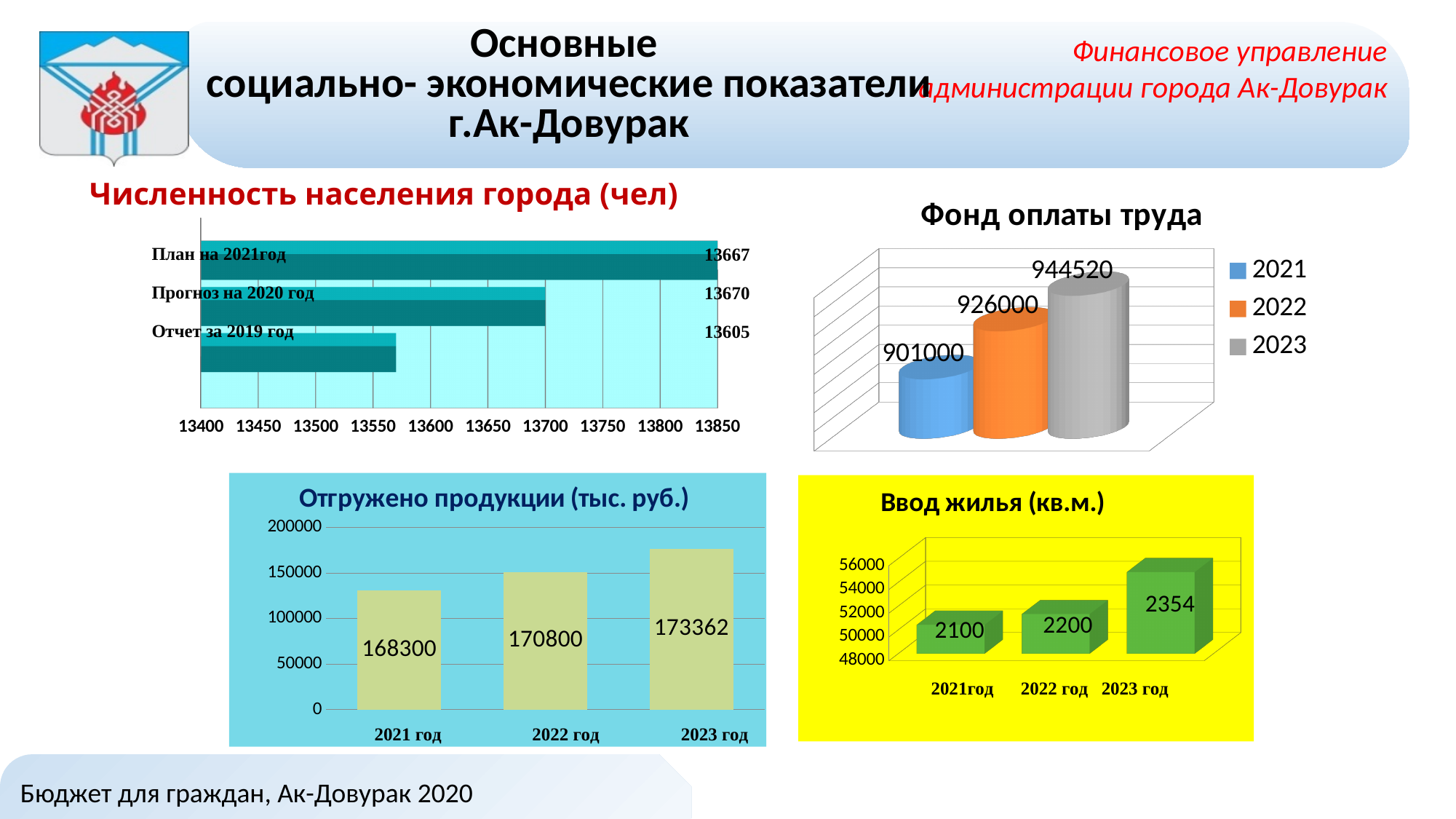
In the chart 'Фонд оплаты труда', do the values rise or fall from 2021 to 2023? rise In the chart 'Численность населения города (чел)', what value is shown for 'Прогноз на 2020 год'? 13670 In the chart 'Ввод жилья (кв.м.)', how many categories are shown? 3 In the chart 'Численность населения города (чел)', what value is shown for 'Отчет за 2019 год'? 13605 In the chart 'Фонд оплаты труда', what is the difference between the 2022 and 2021 values? 25000 In the chart 'Отгружено продукции (тыс. руб.)', which year has the highest value? 2023 год How many entries does the legend of the chart 'Фонд оплаты труда' list? 3 What kind of chart is 'Отгружено продукции (тыс. руб.)'? bar chart In the chart 'Отгружено продукции (тыс. руб.)', what is the value for 2022 год? 170800 In the chart 'Ввод жилья (кв.м.)', what is the value for 2023 год? 2354 In the chart 'Фонд оплаты труда', what is the value for 2023? 944520 In the chart 'Численность населения города (чел)', which category has the lowest value? Отчет за 2019 год